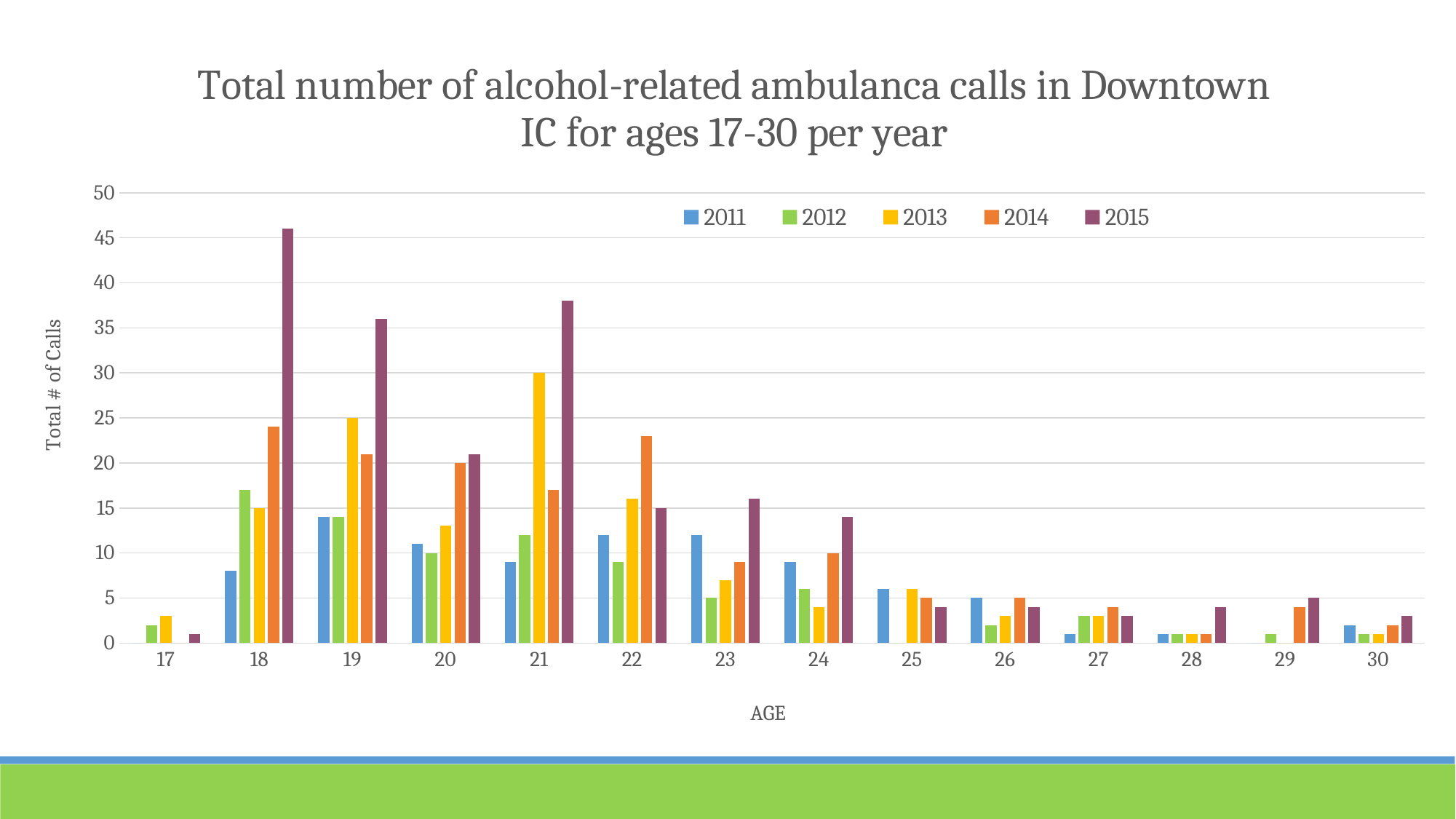
Is the value for 2015 at age 18 greater or less than 45? greater How many age categories are shown on the x axis? 14 Which is larger: the 2015 value at age 18 or the 2015 value at age 21? 2015 at age 18 Which age and year has the highest number of calls in the chart? age 18, 2015 What is the title of the chart? Total number of alcohol-related ambulanca calls in Downtown IC for ages 17-30 per year What kind of chart is shown on the slide? bar chart Is the value for 2015 at age 19 greater or less than 35? greater What is the label of the vertical axis? Total # of Calls Which is larger at age 21: the 2013 value or the 2014 value? 2013 Is the value for 2014 at age 22 greater or less than 20? greater How many series does the legend list? 5 Which age group has the lowest total number of calls across all years? 17